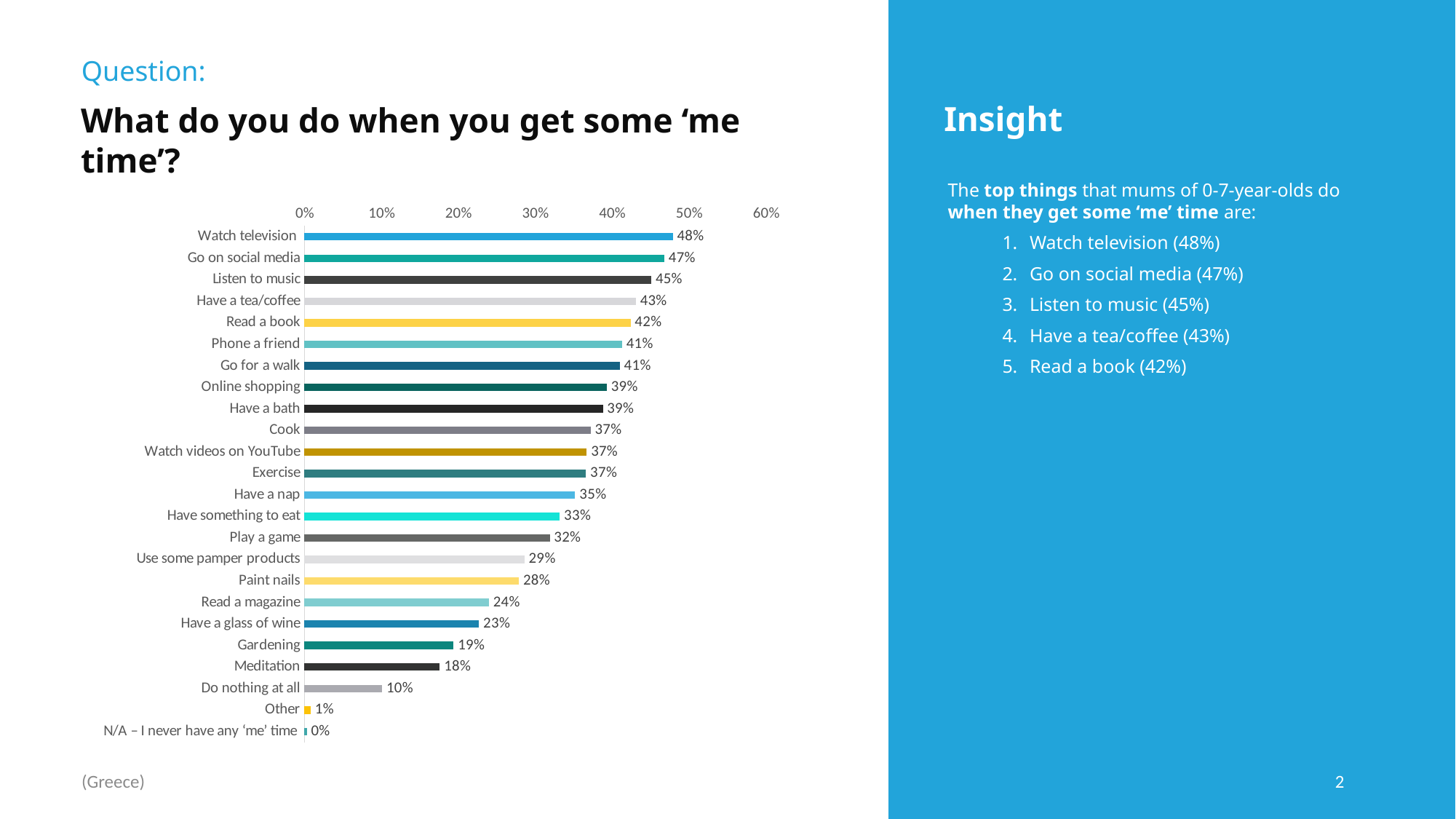
What percentage of respondents said they watch television during 'me time'? 48% What is the difference between 'Have a glass of wine' and 'Meditation'? 5% What is the value shown for 'Have a nap'? 35% Is the value for 'Gardening' greater or less than 20%? less What is the difference between the percentages for 'Go on social media' and 'Read a book'? 5% What percentage is shown for 'Do nothing at all'? 10% Which is larger, the value for 'Paint nails' or the value for 'Read a magazine'? Paint nails Which activity has the highest percentage on the chart? Watch television What is the highest tick value shown on the percentage axis? 60% How many categories are plotted on the chart? 24 Which category has the lowest value on the chart? N/A – I never have any 'me' time What type of chart is shown on the slide? Bar chart